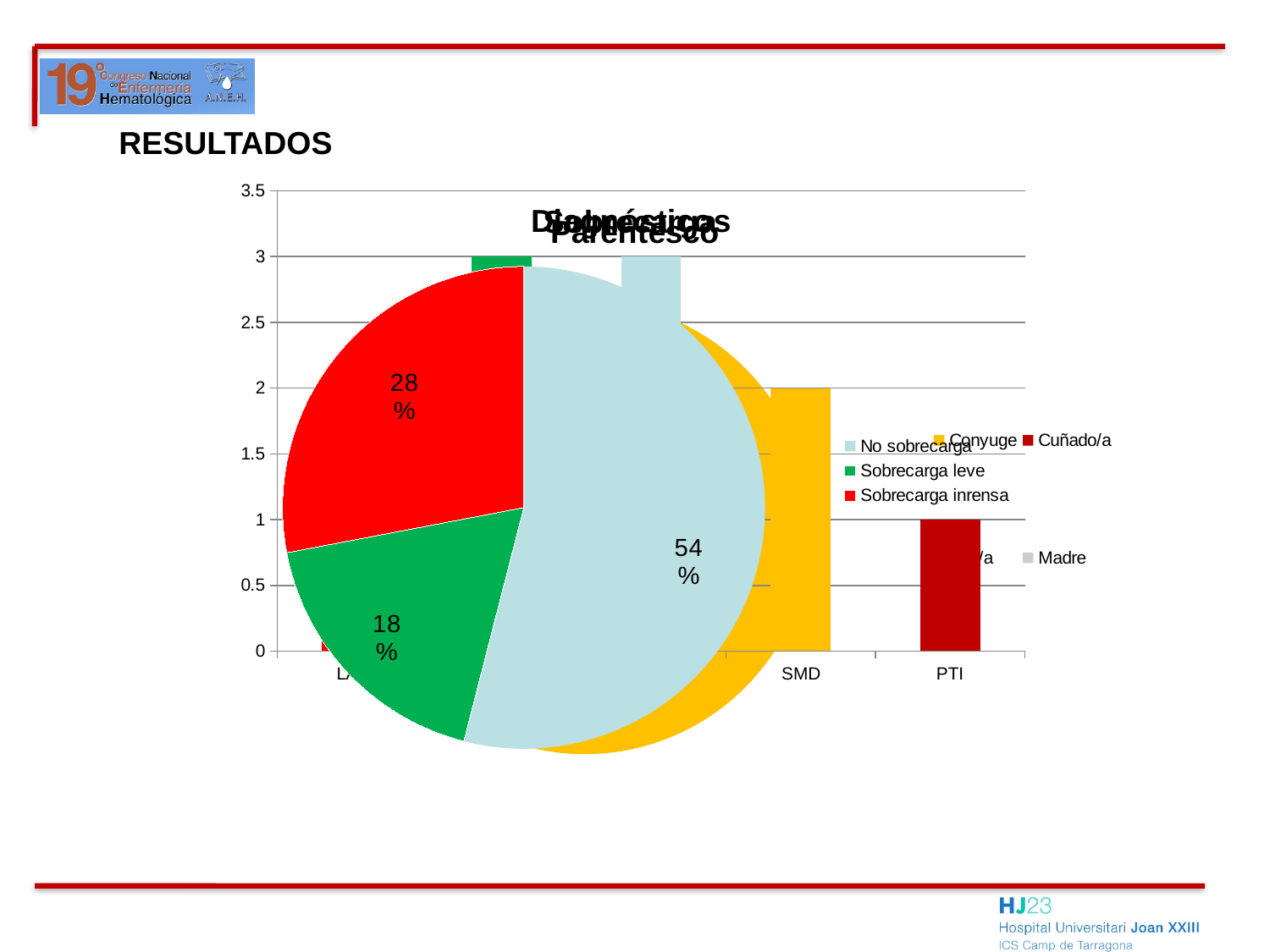
On the foreground pie chart, what percentage is shown on the red slice (Sobrecarga inrensa)? 28% On the bar chart in the background, which bar is taller: SMD or PTI? SMD On the bar chart in the background (categories SMD and PTI visible), is the value for SMD greater or less than 1.5? greater On the pie chart in the foreground (legend: No sobrecarga, Sobrecarga leve, Sobrecarga inrensa), what share is labelled on the largest slice? 54% What kind of chart is the chart in the foreground with the 54%, 28% and 18% labels? Pie chart On the foreground pie chart, what percentage is shown on the green slice (Sobrecarga leve)? 18% On the foreground pie chart, which category has the largest slice? No sobrecarga How many entries does the legend of the foreground pie chart list? 3 On the foreground pie chart, how many percentage points larger is the No sobrecarga slice than the Sobrecarga inrensa slice? 26 On the foreground pie chart, which slice is larger: Sobrecarga leve or Sobrecarga inrensa? Sobrecarga inrensa On the foreground pie chart, which category has the smallest slice? Sobrecarga leve On the bar chart in the background, is the value for PTI greater or less than 1.5? less